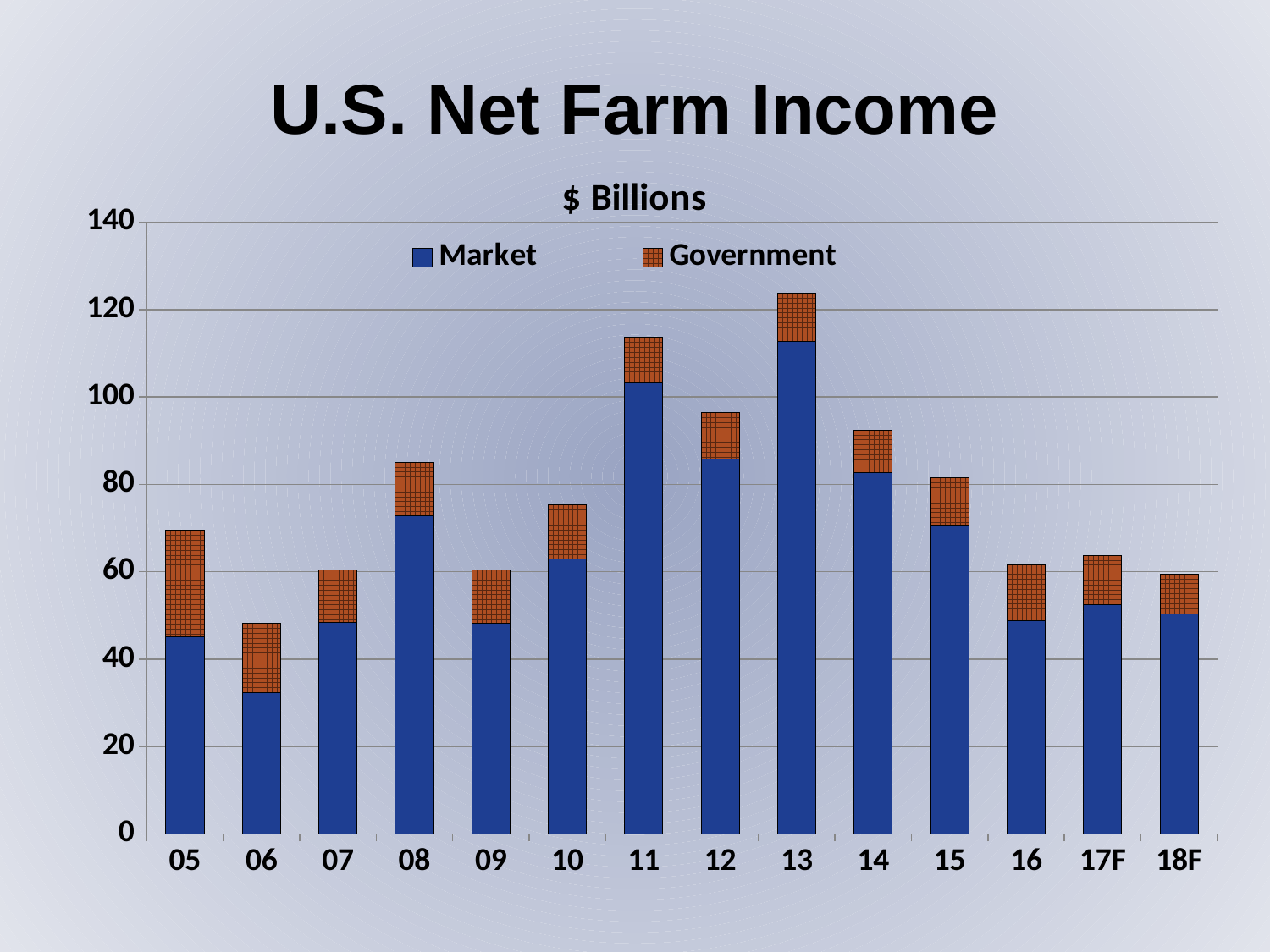
Is the total value for 06 greater or less than 60? less Do the total values rise or fall from 13 to 16? fall How many years (categories) are shown on the x axis? 14 Is the total value for 08 greater or less than 80? greater How many series does the legend list? 2 Which has the larger total net farm income, 08 or 10? 08 Which year has the highest total net farm income? 13 What unit is stated above the chart? $ Billions Which year has the lowest total net farm income? 06 Is the total value for 13 greater or less than 120? greater What kind of chart is shown on the slide? Bar chart (stacked)